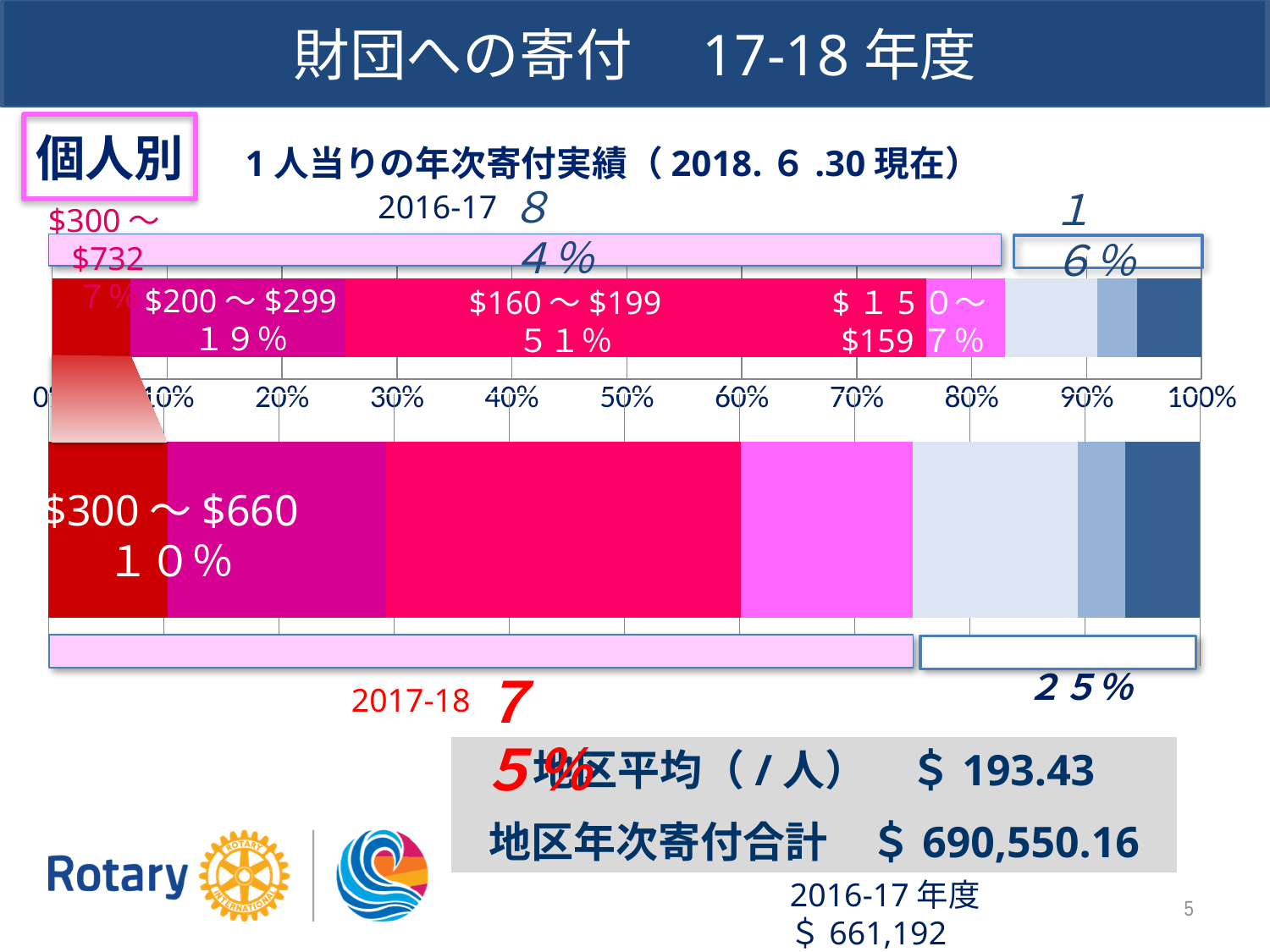
In the 2016-17 bar, what percentage is shown for the $160～$199 range? 51% What type of chart is shown on the slide? Stacked bar chart In the 2017-18 bar, what percentage is shown for the $300～$660 range? 10% What is the highest value shown on the percentage axis? 100% In the 2016-17 bar, which has the larger share: $200～$299 or $150～$159? $200～$299 In the 2016-17 bar, what percentage is shown for the $150～$159 range? 7% What percentage is shown in the blue bracket below the 2017-18 bar? 25% What percentage is shown in the pink bracket above the 2016-17 bar? 84% In the 2016-17 bar, what percentage is shown for the $200～$299 range? 19% What is the difference in percentage points between the blue bracket for 2017-18 (25%) and the blue bracket for 2016-17 (16%)? 9 percentage points In the 2016-17 bar, what is the difference in percentage points between the $160～$199 share and the $200～$299 share? 32 percentage points Which labeled range in the 2016-17 bar has the largest share? $160～$199